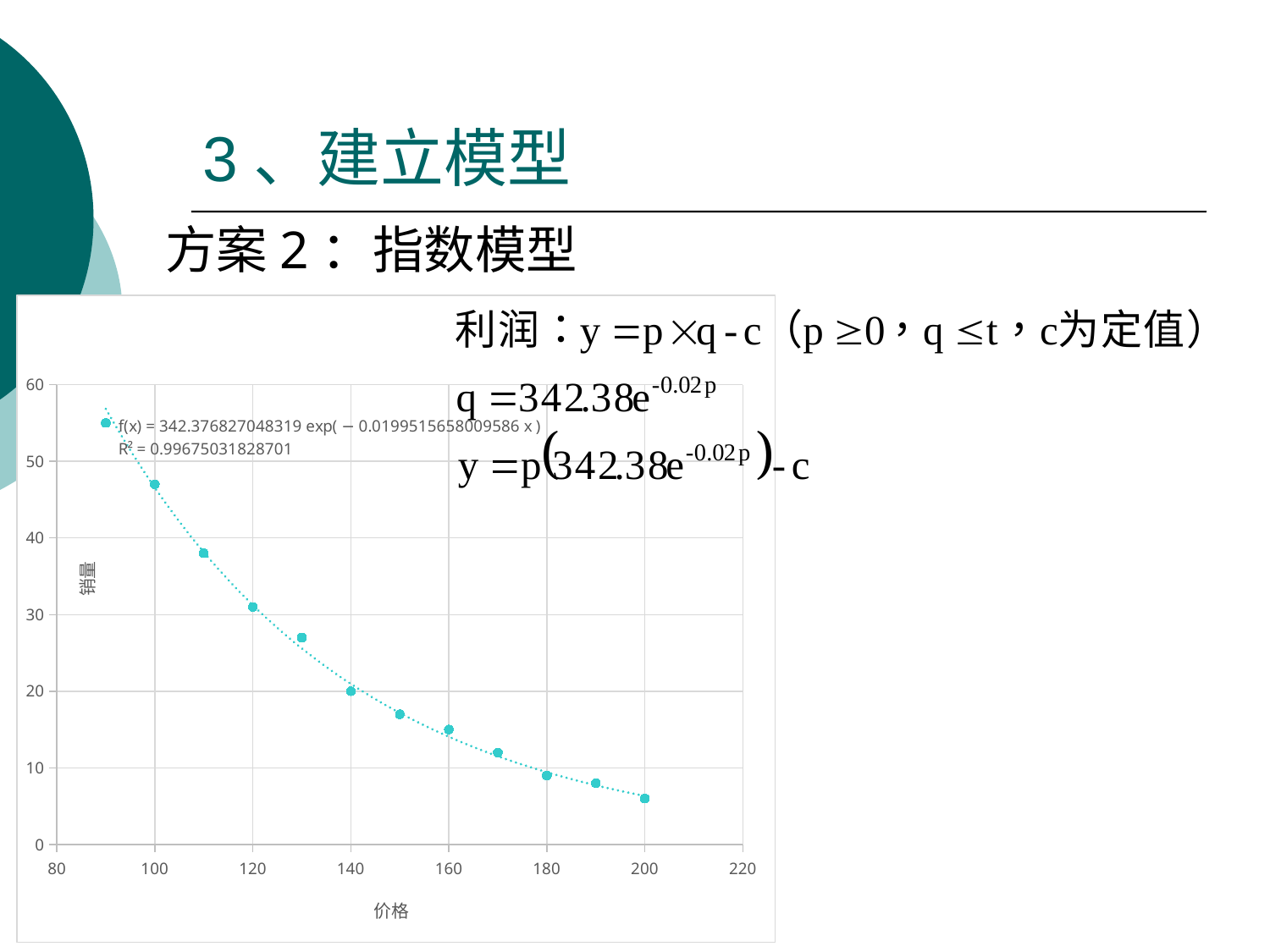
Do the sales values (销量) rise or fall as price (价格) increases along the x axis? fall Is the sales value at price 160 greater or less than 20? less What is the title of the x axis of the chart? 价格 How many data points are plotted in the chart? 12 Is the sales value at price 100 greater or less than 40? greater What R² value is printed on the chart for the fitted trendline? 0.99675031828701 Is the sales value at price 90 greater or less than 50? greater At which price (价格) is the sales value (销量) highest? 90 At which price (价格) is the sales value (销量) lowest? 200 Which has the larger sales value: price 100 or price 140? price 100 What kind of chart is shown on the slide? scatter chart